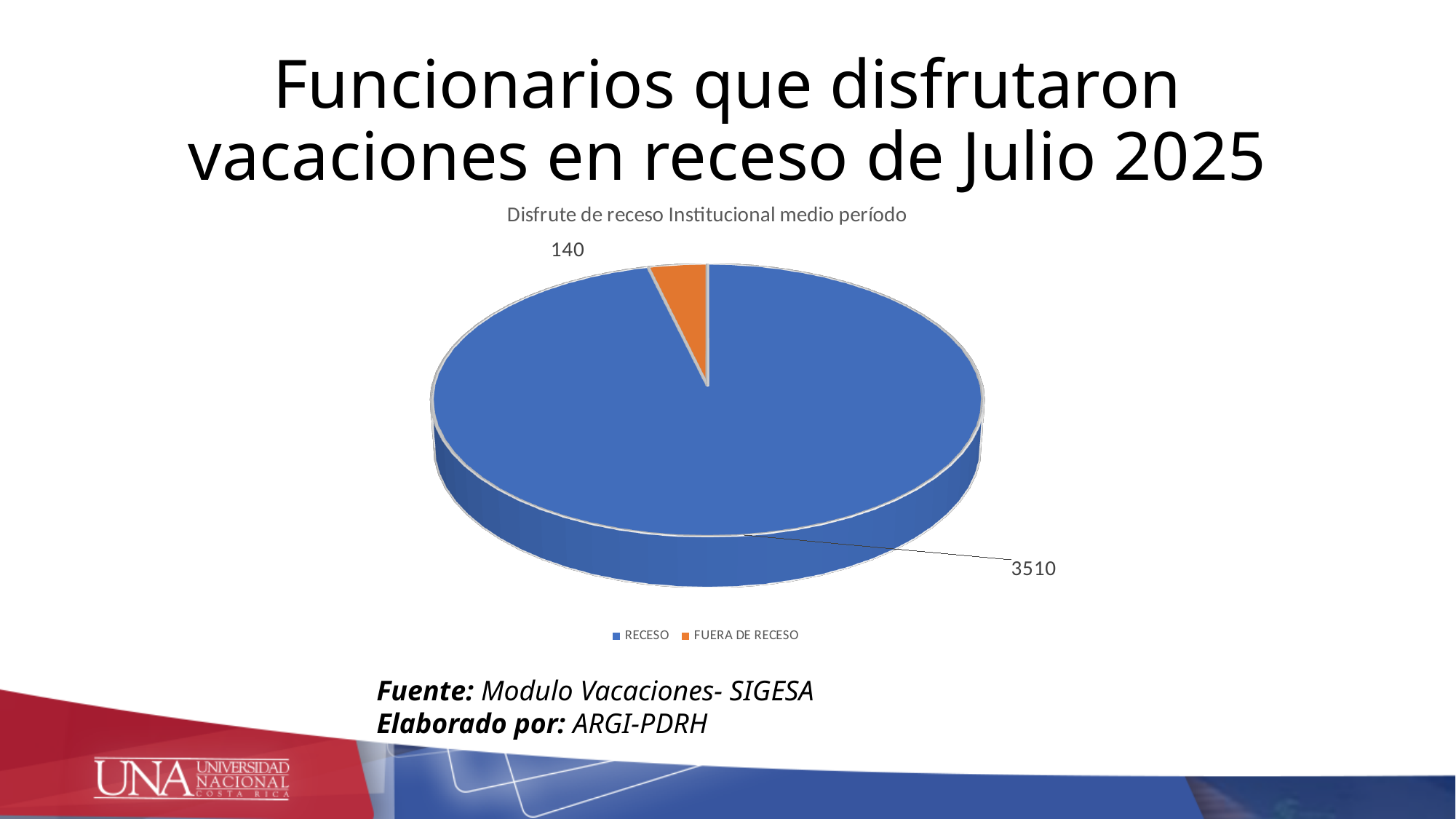
Which is larger, the value for RECESO or the value for FUERA DE RECESO? RECESO What is the value for FUERA DE RECESO in the pie chart? 140 Which category has the smallest slice in the pie chart? FUERA DE RECESO What colour is the FUERA DE RECESO slice in the pie chart? orange What type of chart is shown on the slide? pie chart Which category has the largest slice in the pie chart? RECESO How many entries does the legend of the pie chart list? 2 What is the total of all slices in the pie chart? 3650 What is the chart title shown above the pie chart? Disfrute de receso Institucional medio período What is the value for RECESO in the pie chart? 3510 What is the difference between the RECESO and FUERA DE RECESO values? 3370 How many slices does the pie chart have? 2